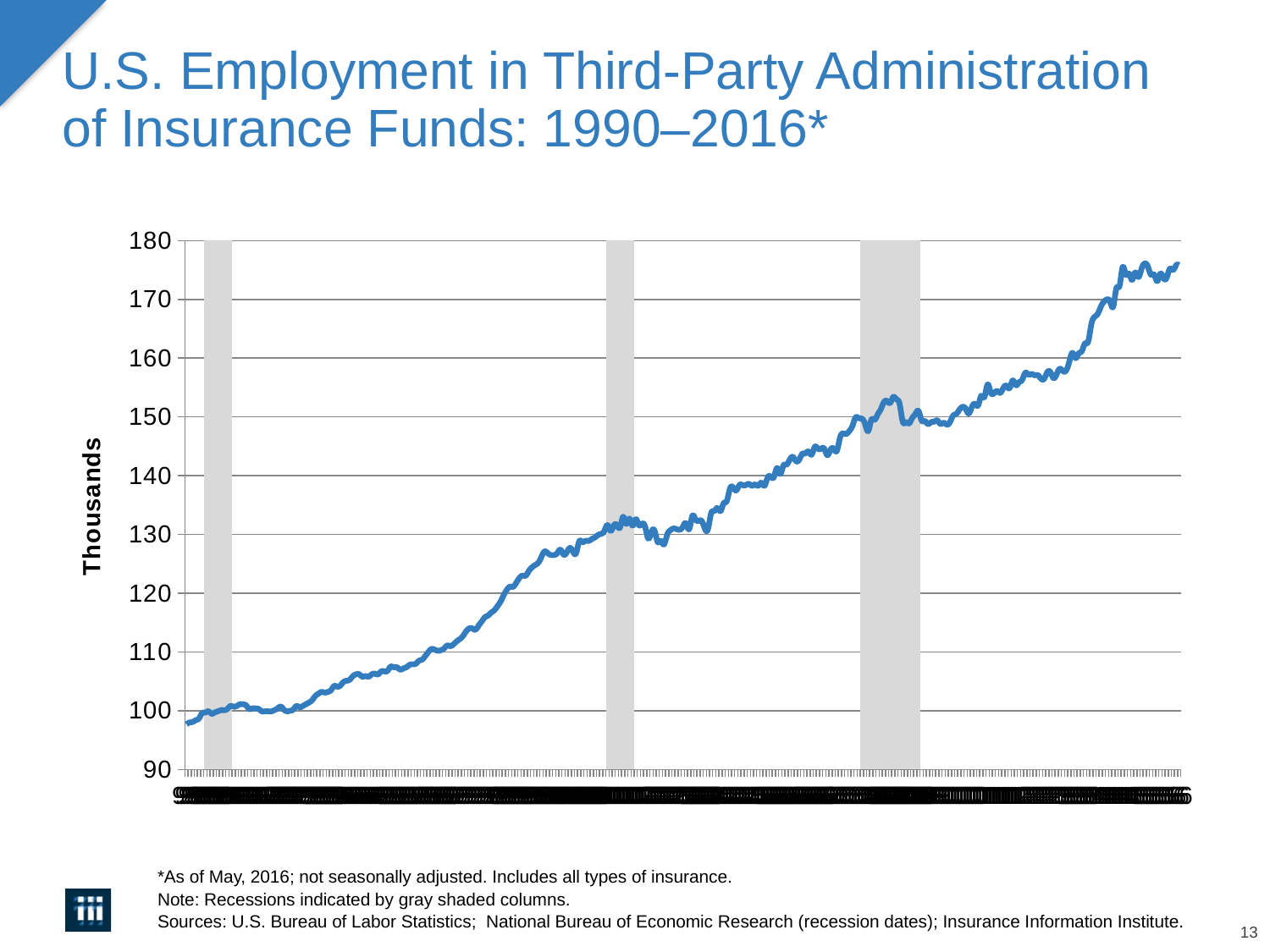
Overall, do the values on the chart rise or fall from left to right along the x axis? rise What is the title of the chart on the slide? U.S. Employment in Third-Party Administration of Insurance Funds: 1990–2016* What kind of chart is shown on the slide? line chart What is the label on the vertical axis of the chart? Thousands Is the value at the right-hand end of the line greater or less than the value at the left-hand start of the line? greater Is the highest point on the line greater or less than 170? greater How many lines (data series) are plotted on the chart? 1 What is the lowest value shown on the vertical axis of the chart? 90 Is the lowest point on the line greater or less than 110? less Is the value at the right-hand end of the line greater or less than 170? greater